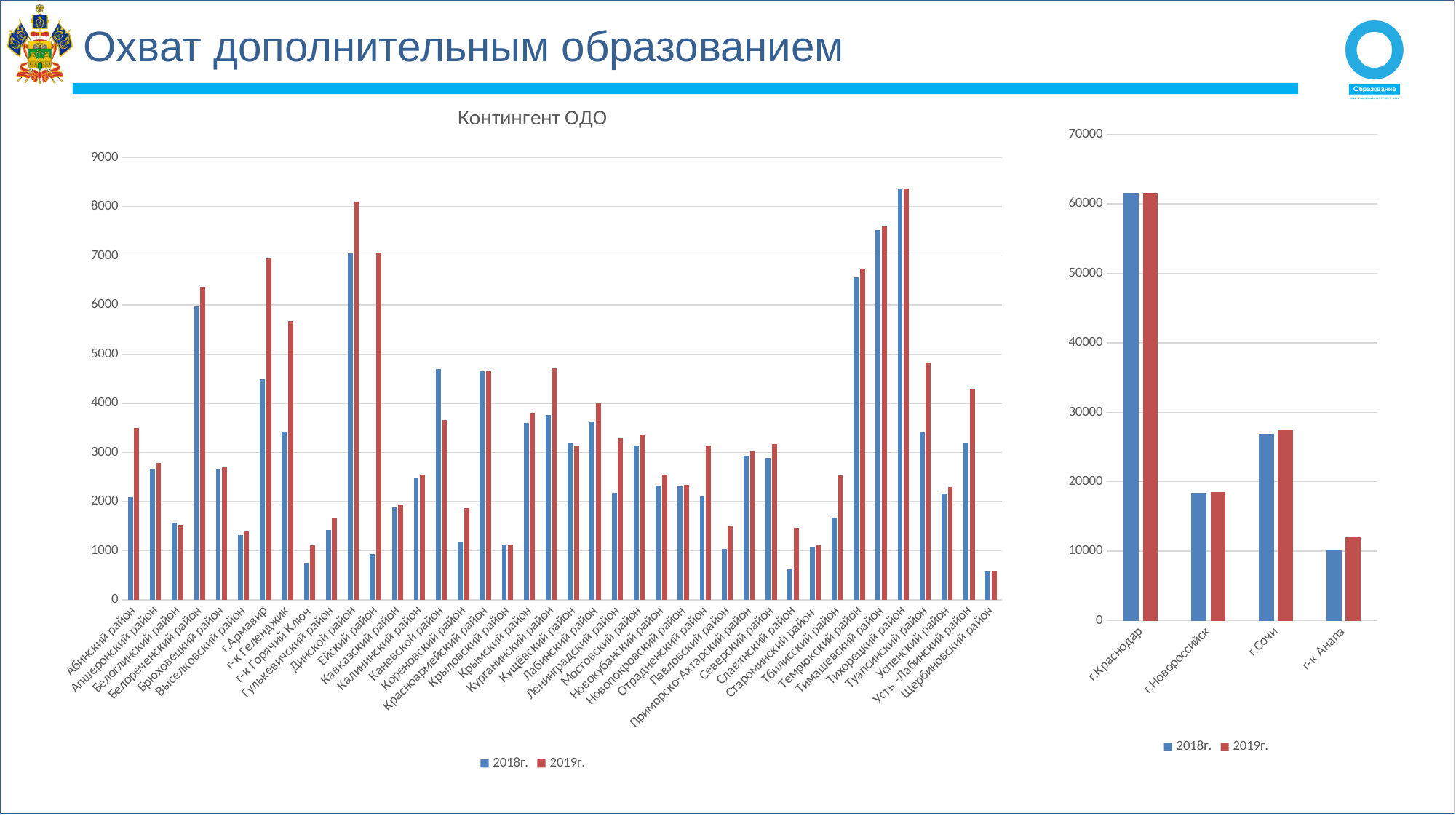
In the chart titled "Контингент ОДО", which is larger for Белореченский район: the 2018г. value or the 2019г. value? 2019г. In the chart on the right of the slide, is the 2018г. value for г.Краснодар greater or less than 60000? greater In the chart titled "Контингент ОДО", which category has the lowest values? Щербиновский район In the chart on the right of the slide, which category has the lowest values? г-к Анапа In the chart titled "Контингент ОДО", is the 2019г. value for Динской район greater or less than 8000? greater How many categories are shown on the x axis of the chart on the right of the slide? 4 In the chart titled "Контингент ОДО", which category has the highest values? Тихорецкий район How many series does the legend of the chart titled "Контингент ОДО" list? 2 In the chart titled "Контингент ОДО", is the 2018г. value for Кореновский район greater or less than 4000? less What kind of chart is the chart titled "Контингент ОДО"? bar chart In the chart titled "Контингент ОДО", which is larger for Кореновский район: the 2018г. value or the 2019г. value? 2019г. In the chart on the right of the slide, which category has the highest values? г.Краснодар